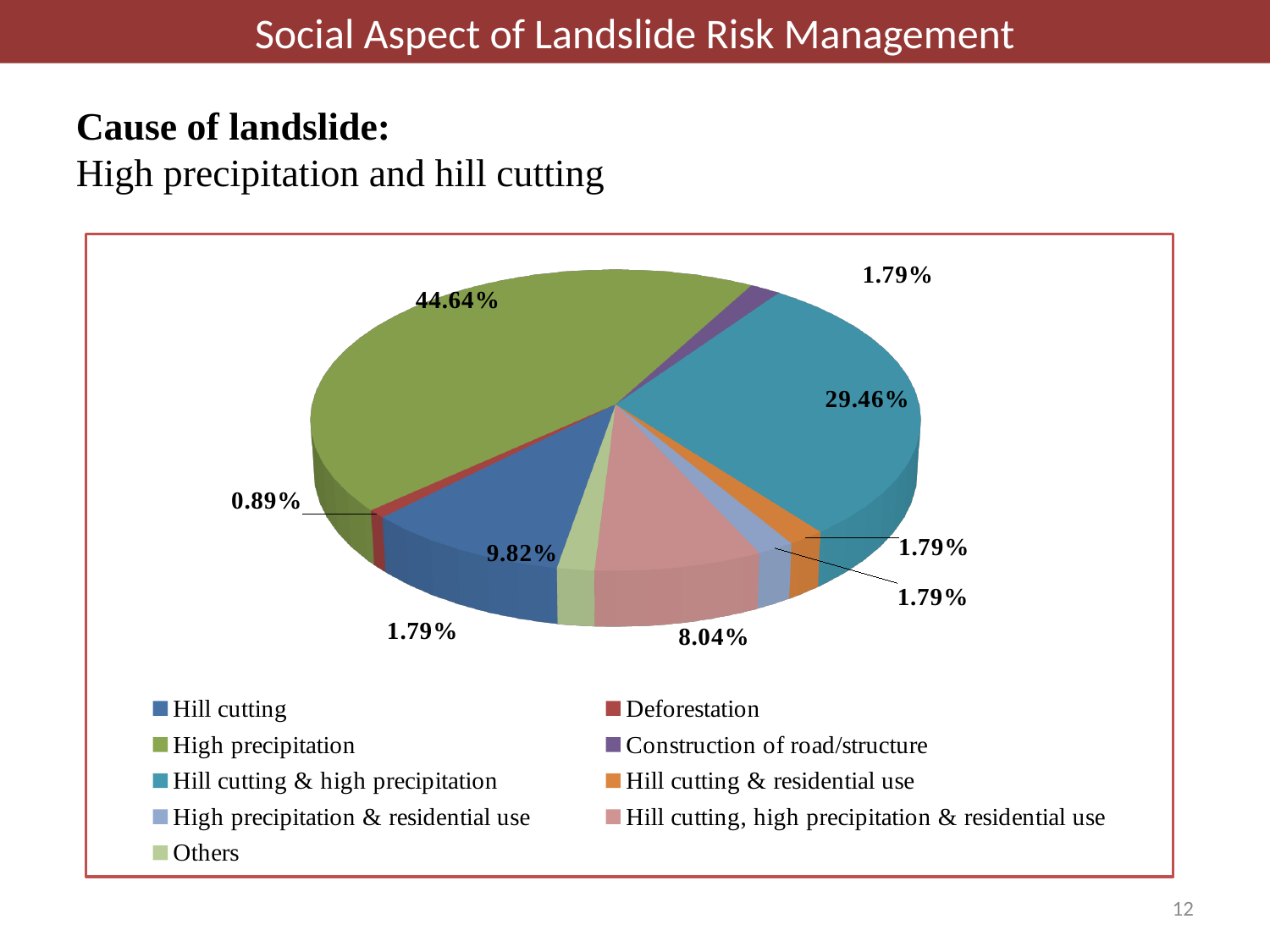
What is the value for Hill cutting & high precipitation? 29.46% What kind of chart is shown on the slide? pie chart Which cause has the smallest slice of the pie? Deforestation What is the value for Hill cutting, high precipitation & residential use? 8.04% How many categories does the legend list? 9 What is the value for Deforestation? 0.89% What is the value for Hill cutting? 9.82% What share of the pie does High precipitation account for? 44.64% Which is larger, the share for Hill cutting or the share for Hill cutting, high precipitation & residential use? Hill cutting Which cause has the largest slice of the pie? High precipitation What is the difference between the shares for High precipitation and Hill cutting & high precipitation? 15.18% What colour is the slice for Hill cutting & high precipitation? teal